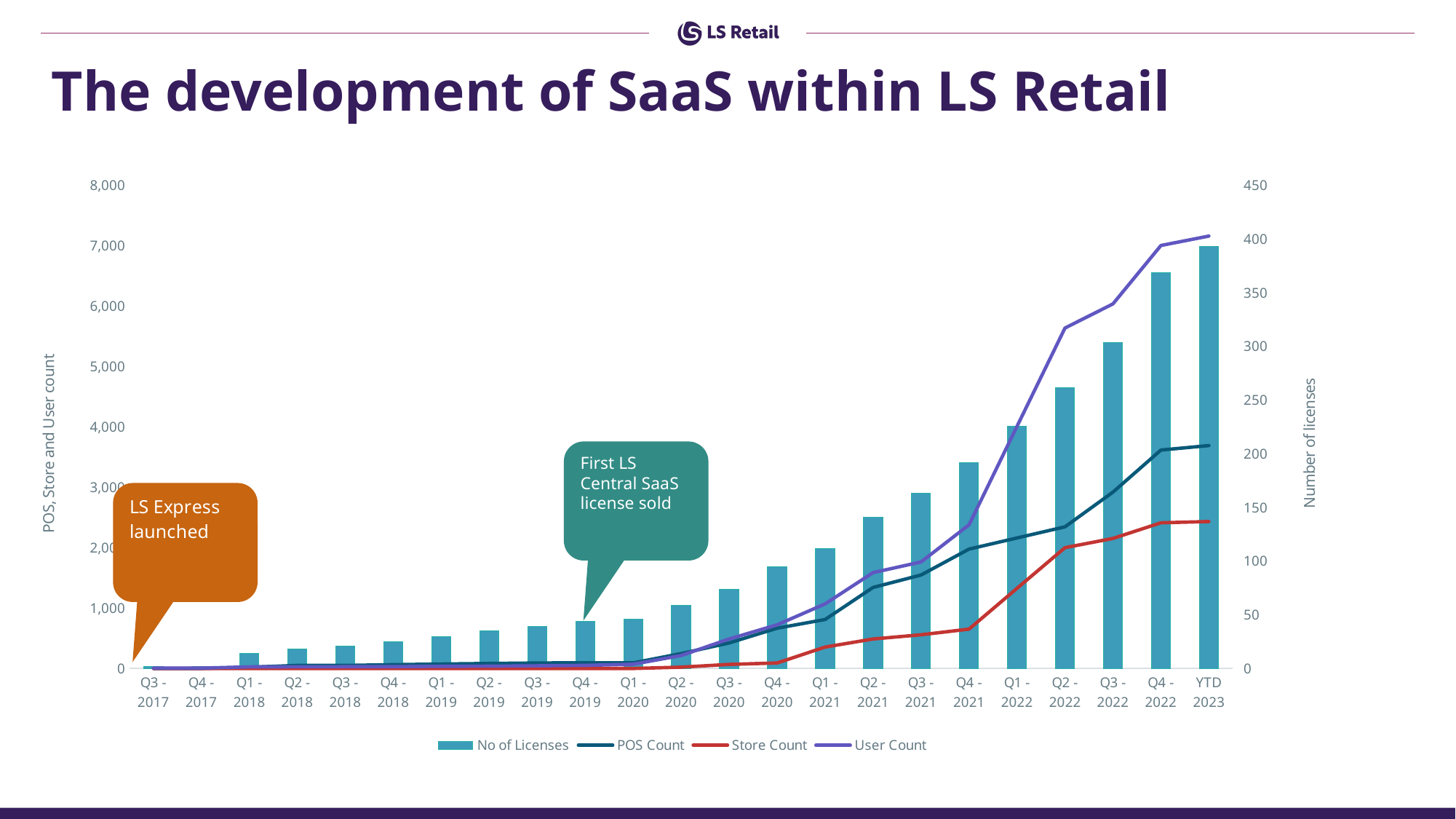
Is the No of Licenses value for YTD 2023 greater or less than 350? greater Which period has the highest No of Licenses bar? YTD 2023 What kind of chart is shown on the slide? Combined bar and line chart At YTD 2023, which is larger, the User Count or the POS Count? User Count Is the Store Count for Q4 - 2021 greater or less than 1,000? less What is the title of the right-hand vertical axis? Number of licenses Do the No of Licenses values generally rise or fall from Q3 - 2017 to YTD 2023? rise How many quarters/periods are shown along the x axis? 23 Is the User Count for YTD 2023 greater or less than 7,000? greater How many series does the legend list? 4